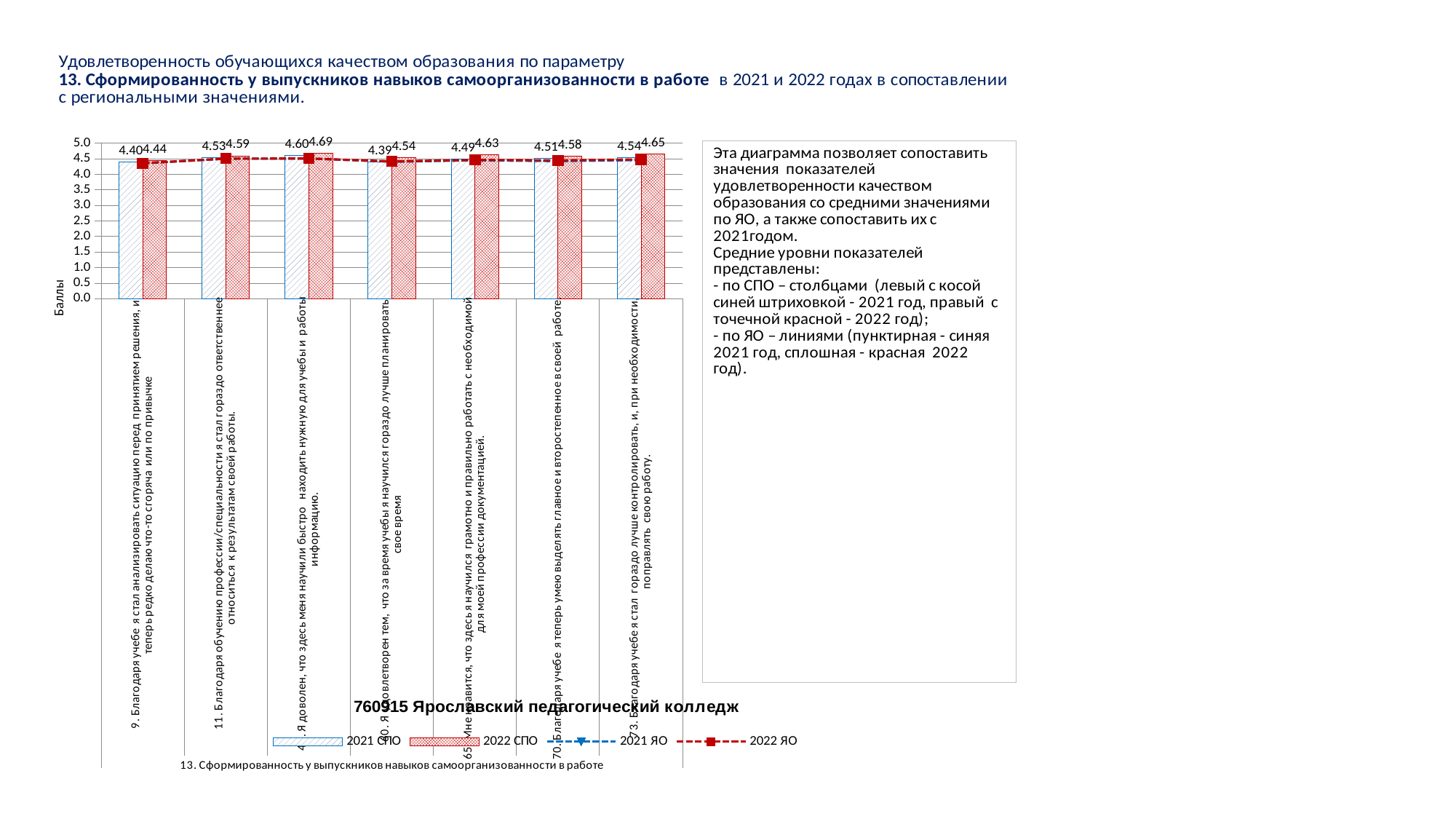
What is the 2022 СПО value for the category about becoming much more responsible for the results of one's work (item 11)? 4.59 What is the label on the vertical axis of the chart? Баллы For item 9 (analysing the situation before making a decision), which is larger: the 2021 СПО value or the 2022 СПО value? 2022 СПО (4.44) Which category has the lowest 2021 СПО value? Я удовлетворен тем, что за время учебы я научился гораздо лучше планировать свое время (4.39) What kind of chart is used to show the СПО values? bar chart How many series does the chart legend list? 4 What is the difference between the 2022 СПО and 2021 СПО values for item 73 (learning to control and correct one's own work)? 0.11 How many question categories are plotted along the x axis of the chart? 7 Which category has the highest 2022 СПО value? Я доволен, что здесь меня научили быстро находить нужную для учебы и работы информацию (4.69) Which series in the legend is drawn as a solid red line with square markers? 2022 ЯО What is the 2021 СПО value for the category about learning to work correctly with professional documentation (item 65)? 4.49